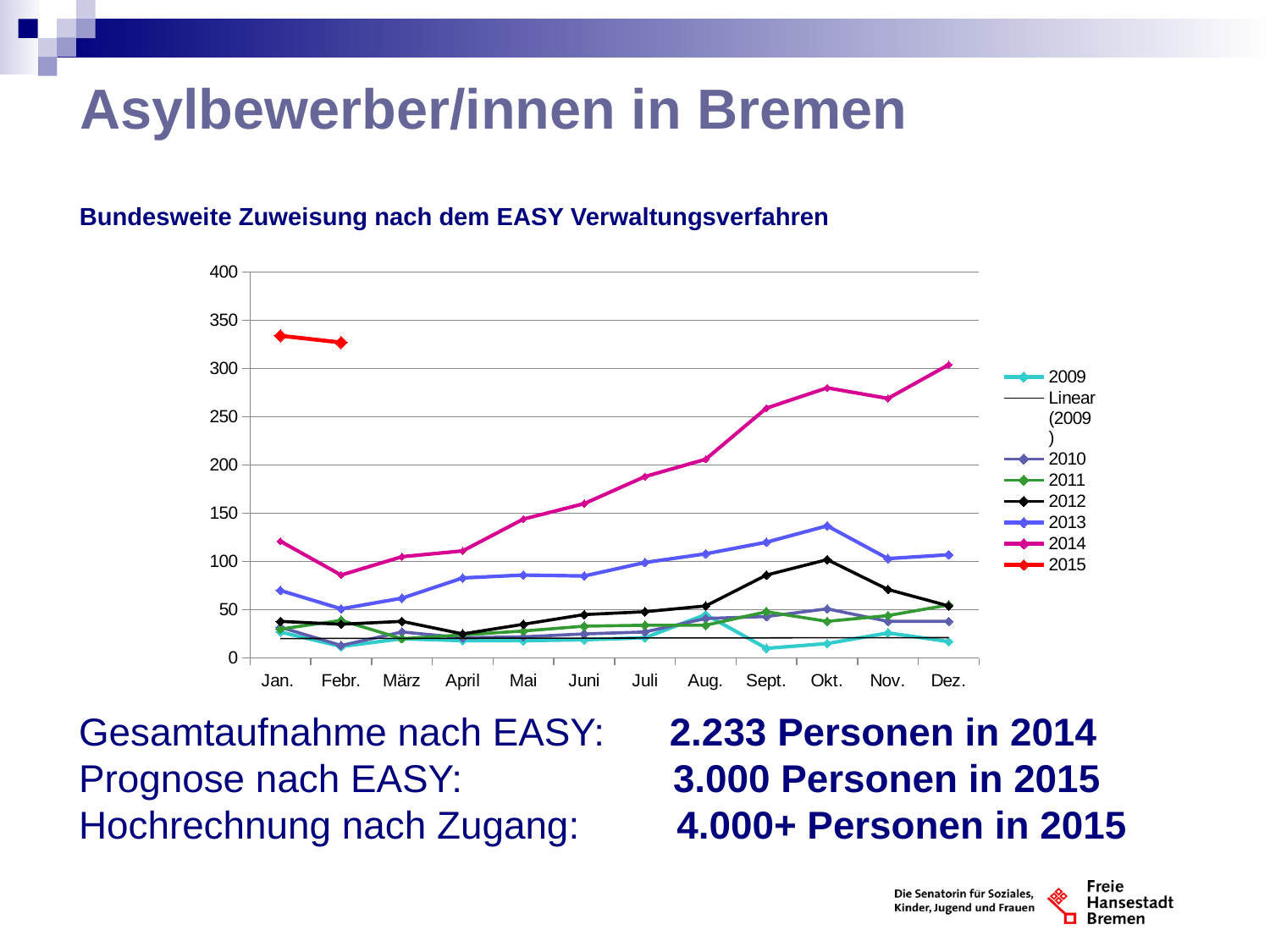
In which month does the 2014 series reach its highest value? Dez. What kind of chart is shown on the slide? Line chart How many entries does the chart's legend list? 8 Is the value for 2013 in Okt. greater or less than 100? greater In which month does the 2014 series have its lowest value? Febr. Which series has the highest value in Okt.? 2014 Is the value for 2014 in Febr. greater or less than 100? less How many months are shown along the x axis of the chart? 12 In Juli, which series has the larger value, 2012 or 2013? 2013 Is the value for 2014 in Okt. greater or less than 250? greater Does the 2014 series rise or fall from Febr. to Dez.? Rise